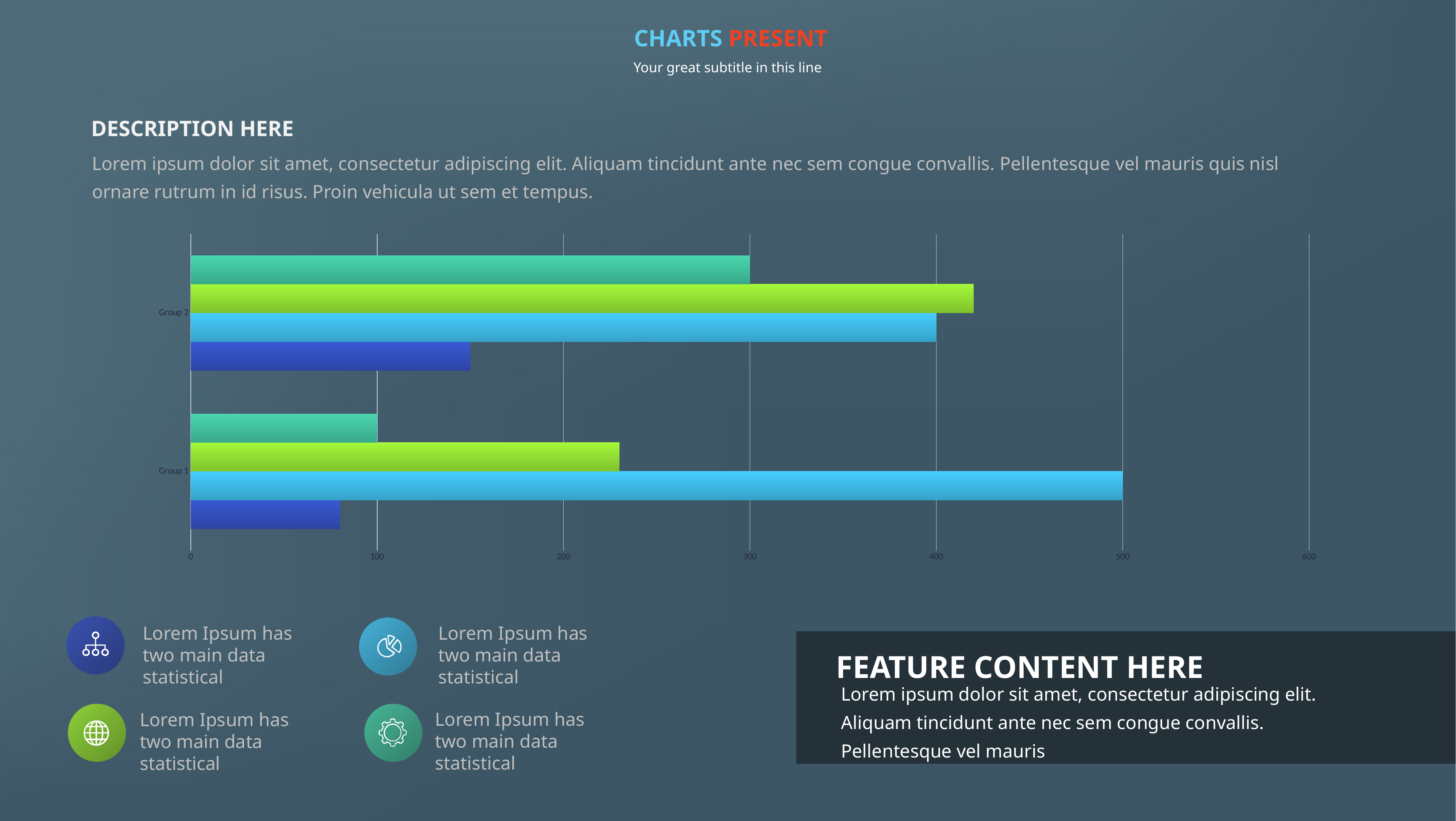
Is the value of the green bar for Group 1 greater or less than 200? greater Which group has the longer dark blue (bottom) bar, Group 1 or Group 2? Group 2 Which bar on the chart is the longest overall? the light blue bar for Group 1 What is the value of the light blue bar for Group 1? 500 What is the value of the teal (top) bar for Group 1? 100 What kind of chart is shown on the slide? bar chart What is the value of the teal (top) bar for Group 2? 300 How many bars are drawn for each group on the chart? 4 Is the value of the dark blue (bottom) bar for Group 1 greater or less than 100? less How many groups (categories) are shown on the chart's vertical axis? 2 What is the value of the light blue bar for Group 2? 400 Is the value of the green bar for Group 2 greater or less than 400? greater